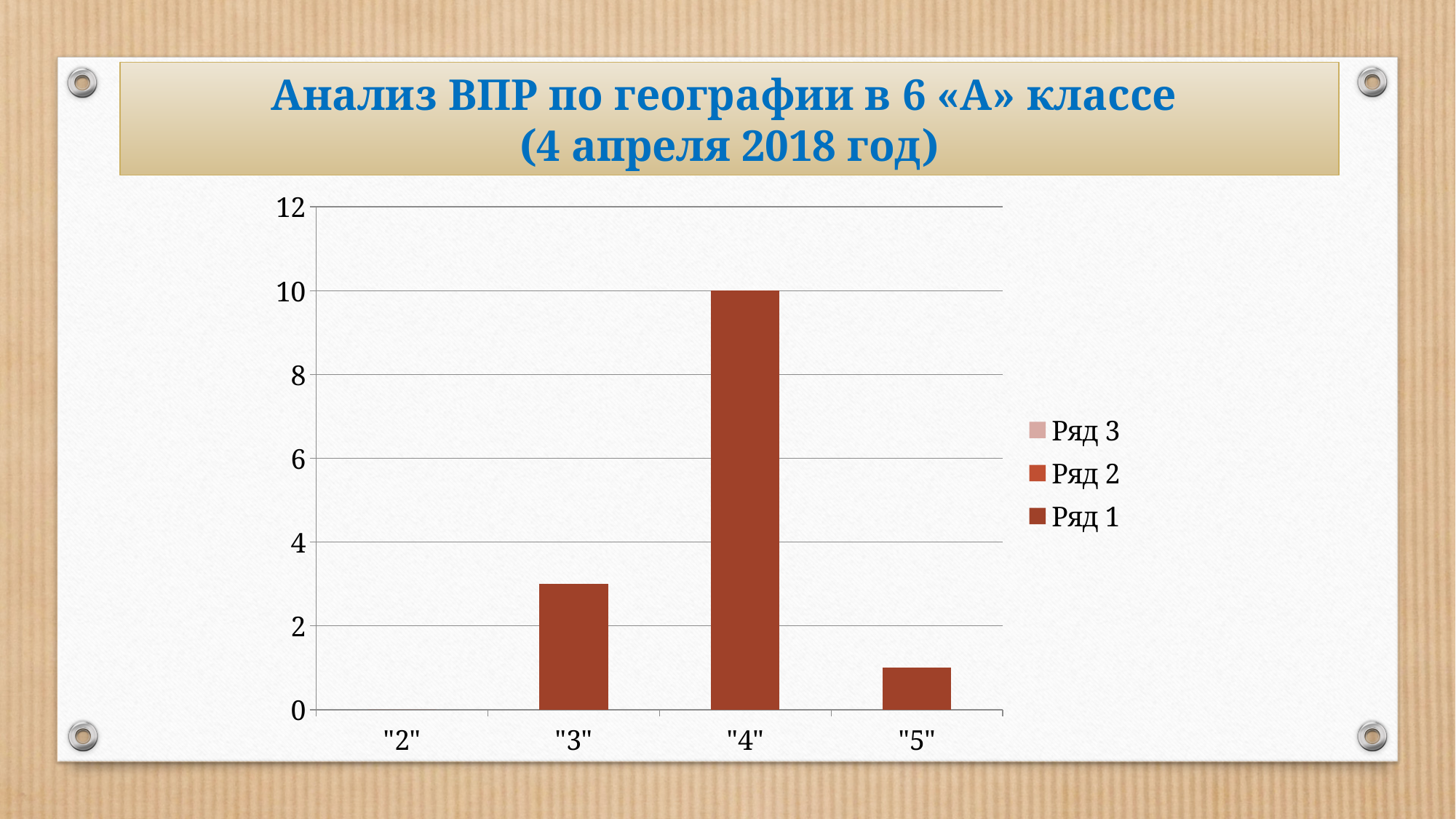
What is the title of the slide? Анализ ВПР по географии в 6 «А» классе (4 апреля 2018 год) What is the value for the category "4"? 10 Is the value for "3" greater or less than 2? greater How many categories are shown on the x axis? 4 What is the difference between the value for "4" and the value for "2"? 10 What kind of chart is shown on the slide? bar chart What is the value for the category "2"? 0 Which category has the lowest value? "2" Is the value for "5" greater or less than 2? less How many series does the legend list? 3 Which category has the highest value? "4" Which is larger, the value for "3" or the value for "5"? "3"